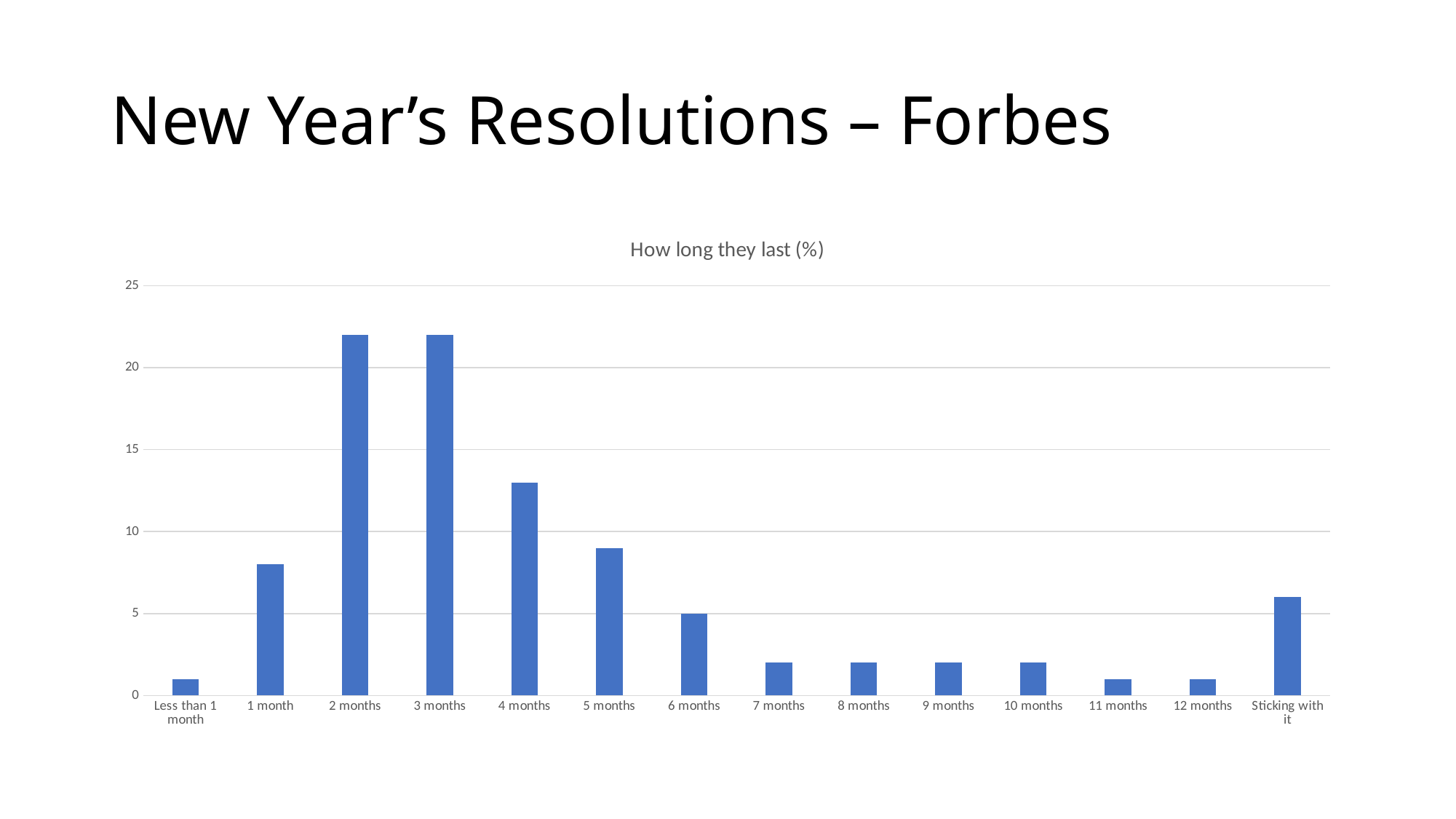
What is the title of the chart? How long they last (%) Do the values rise or fall from 3 months to 7 months? fall Which is larger, the value for 1 month or the value for 2 months? 2 months Is the value for Sticking with it greater or less than 5? greater Is the value for 4 months greater or less than 10? greater Which is larger, the value for 4 months or the value for 5 months? 4 months Is the value for 1 month greater or less than 10? less What kind of chart is shown on the slide? bar chart How many categories are shown on the x axis of the chart? 14 What is the value for 6 months? 5